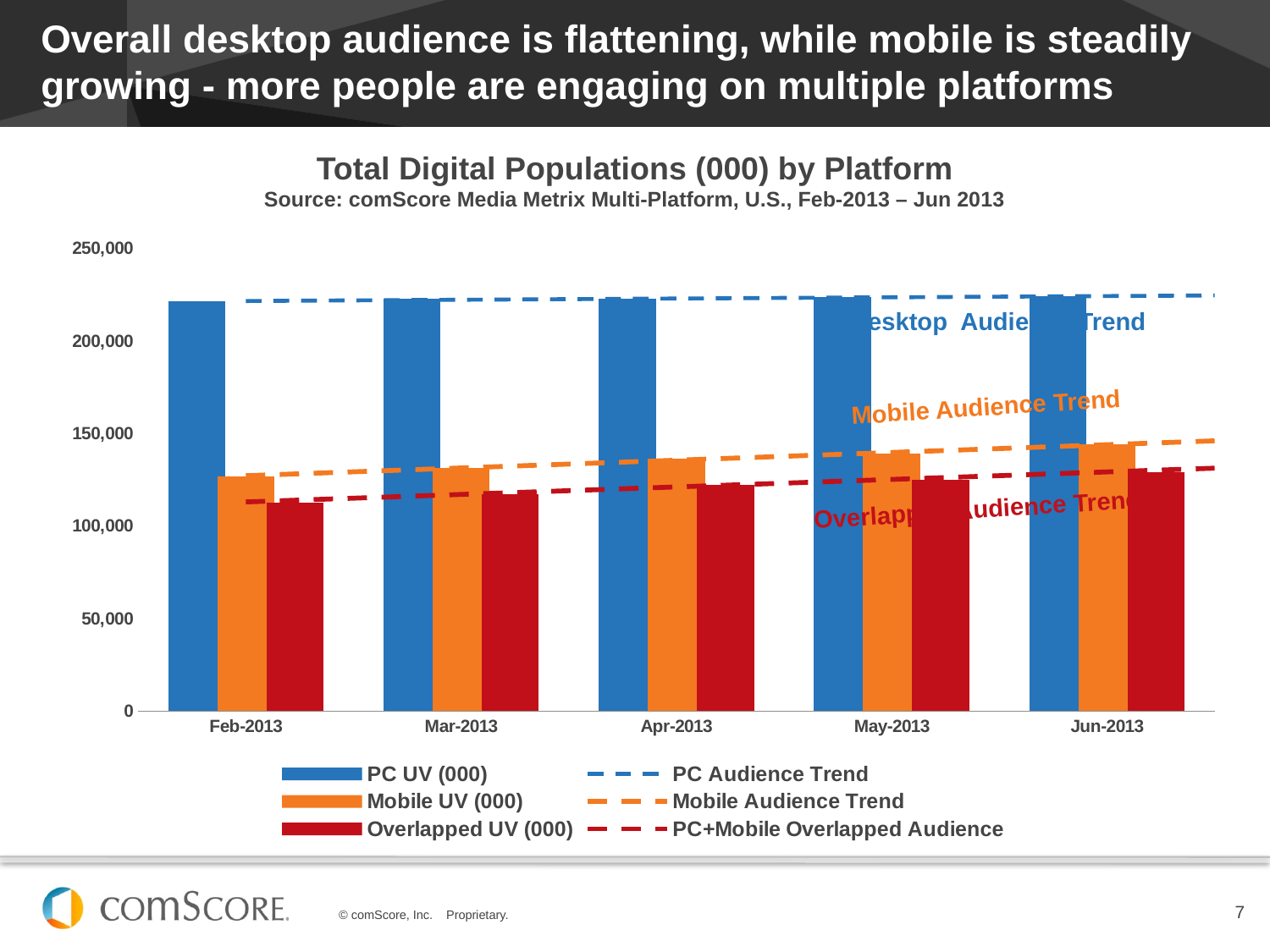
Is the PC UV (000) value for Feb-2013 greater or less than 200,000? greater What kind of chart is shown on the slide? Bar chart with trend lines Is the Mobile UV (000) value for Jun-2013 greater or less than 150,000? less How many series does the chart's legend list? 6 Do the Mobile UV (000) values rise or fall from Feb-2013 to Jun-2013? rise How many months are shown on the x axis of the chart? 5 Which month has the lowest Overlapped UV (000) value? Feb-2013 Which is larger in Apr-2013, PC UV (000) or Mobile UV (000)? PC UV (000) Is the Overlapped UV (000) value for Feb-2013 greater or less than 100,000? greater Which is larger in Mar-2013, Mobile UV (000) or Overlapped UV (000)? Mobile UV (000) Which month has the highest Mobile UV (000) value? Jun-2013 What is the title of the chart? Total Digital Populations (000) by Platform